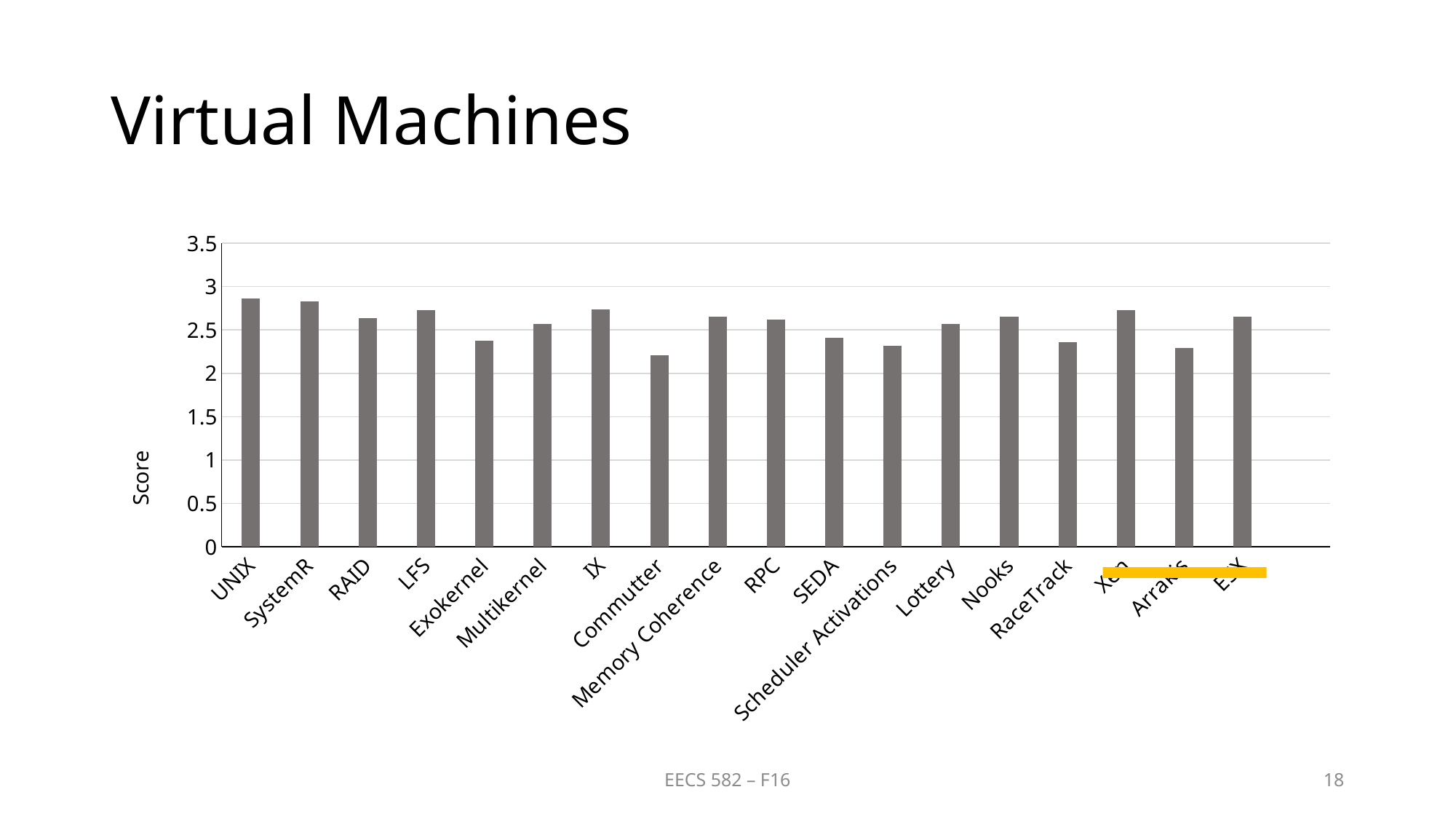
What is the label on the vertical axis of the chart? Score Which has a higher score, SEDA or Memory Coherence? Memory Coherence Which has a higher score, LFS or Exokernel? LFS Is the value for Commutter greater or less than 2.5? less How many categories are plotted along the x axis of the chart? 18 Is the value for Scheduler Activations greater or less than 2? greater Which category has the lowest score in the chart? Commutter Is the value for UNIX greater or less than 2.5? greater Which has a higher score, UNIX or Commutter? UNIX What kind of chart is shown on the slide? bar chart What is the title of the slide containing the chart? Virtual Machines